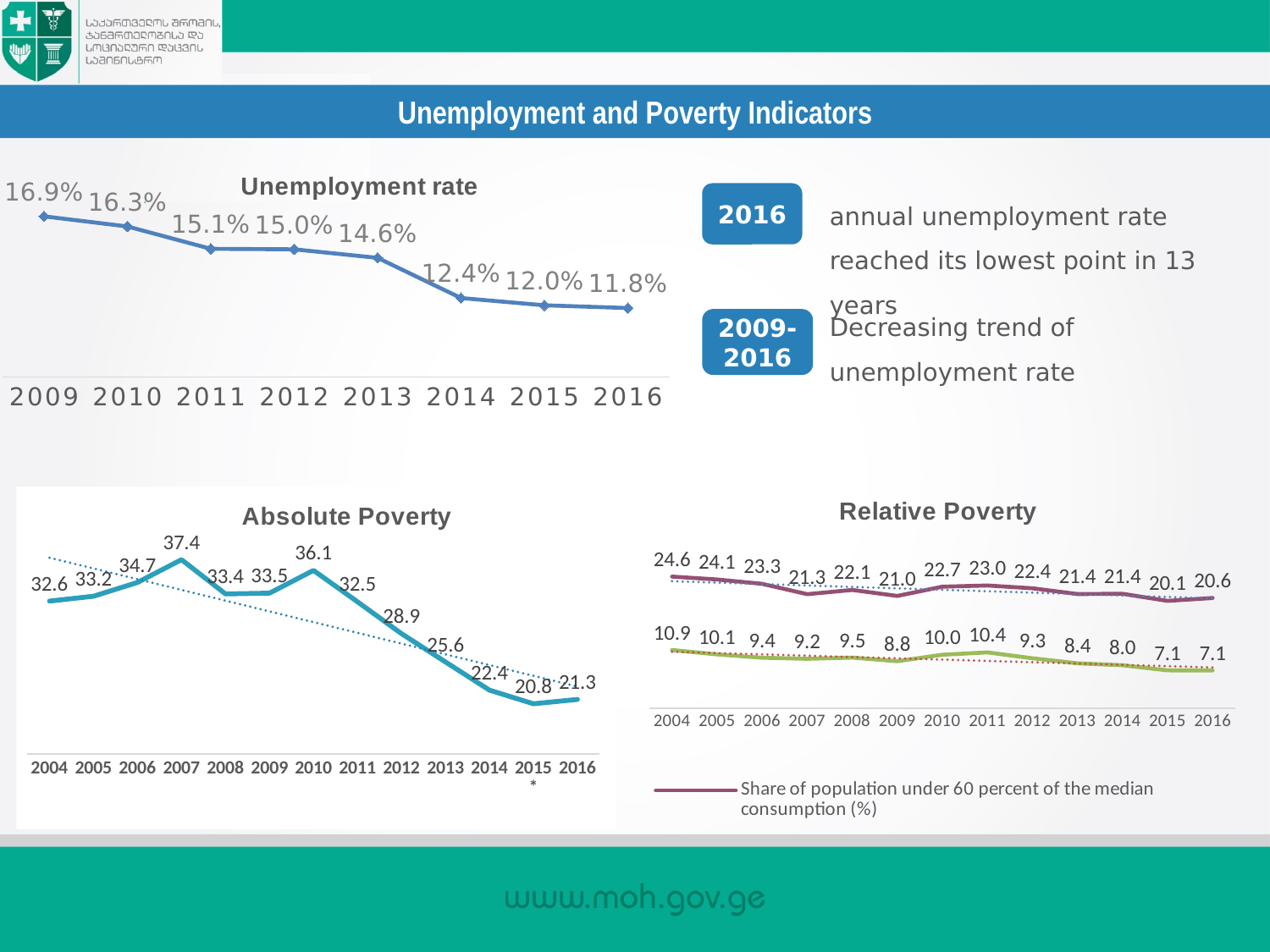
In the Unemployment rate chart, what is the difference between the 2009 and 2016 unemployment rates? 5.1% What type of chart is the Absolute Poverty chart? line chart In the Unemployment rate chart, which year has the highest unemployment rate? 2009 In the Relative Poverty chart, what is the value of the lower line in 2016? 7.1 In the Relative Poverty chart, what is the value of the upper line (share of population under 60 percent of the median consumption) in 2004? 24.6 In the Absolute Poverty chart, which year has the lowest value? 2015 In the Unemployment rate chart, what was the unemployment rate in 2016? 11.8% In the Absolute Poverty chart, what is the difference between the 2010 and 2011 values? 3.6 In the Absolute Poverty chart, which is larger, the value for 2004 or the value for 2016? 2004 In the Unemployment rate chart, how many years are plotted? 8 In the Unemployment rate chart, do the values rise or fall from 2009 to 2016? fall In the Absolute Poverty chart, what is the value for 2007? 37.4